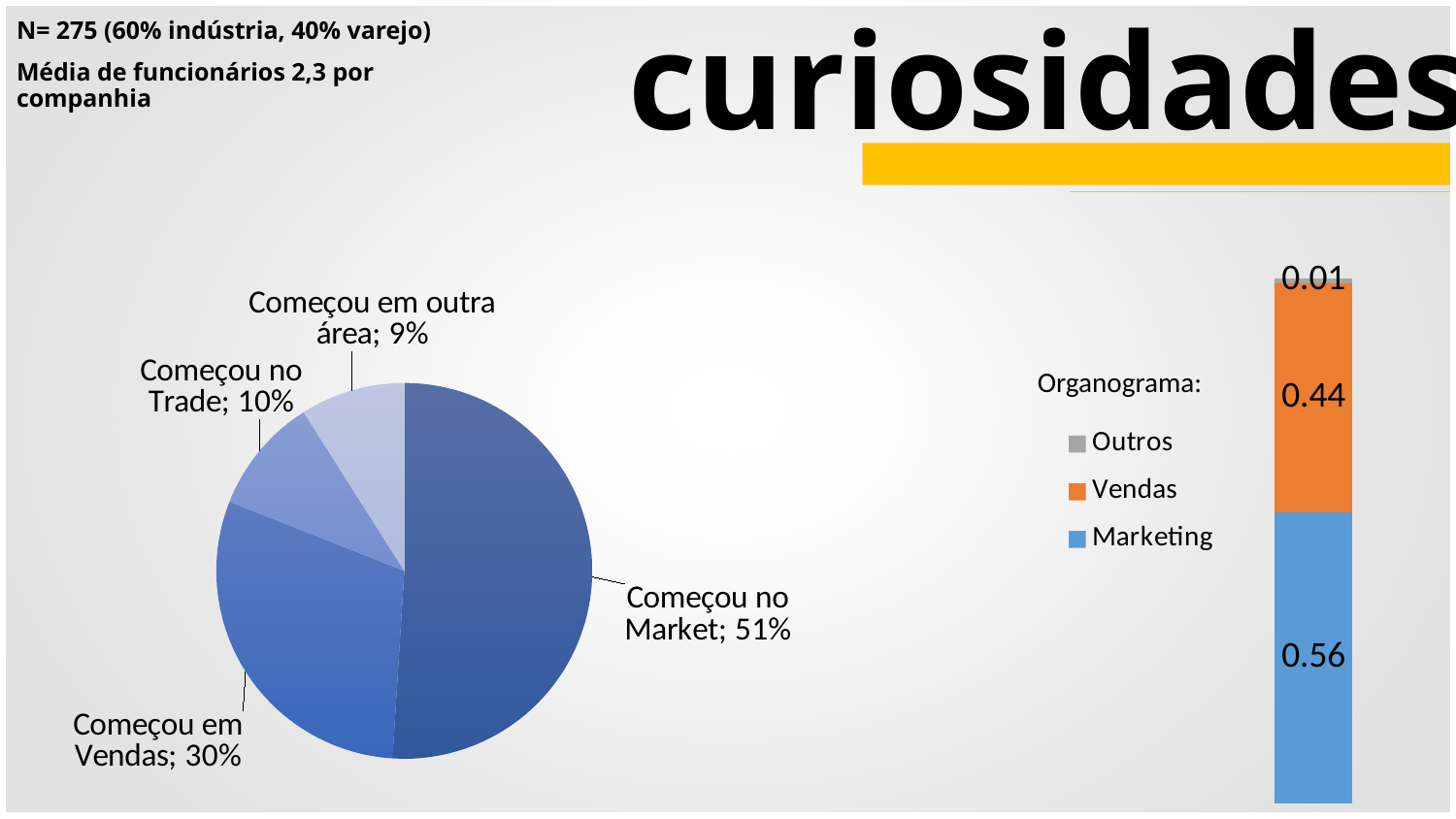
In the pie chart on the left, what share is labelled for "Começou no Market"? 51% In the stacked bar chart on the right (Organograma), which segment is larger, Marketing or Vendas? Marketing In the pie chart on the left, what is the difference between the shares for "Começou no Market" and "Começou em Vendas"? 21 percentage points How many series does the legend of the stacked bar chart on the right (Organograma) list? 3 In the pie chart on the left, how many slices are there? 4 In the pie chart on the left, what share is labelled for "Começou no Trade"? 10% In the pie chart on the left, which category has the smallest slice? Começou em outra área In the stacked bar chart on the right (Organograma), what is the value for Vendas? 0.44 In the pie chart on the left, what share is labelled for "Começou em Vendas"? 30% What kind of chart is the chart on the left of the slide? Pie chart In the pie chart on the left, which category has the largest slice? Começou no Market In the stacked bar chart on the right (Organograma), what is the value for Marketing? 0.56